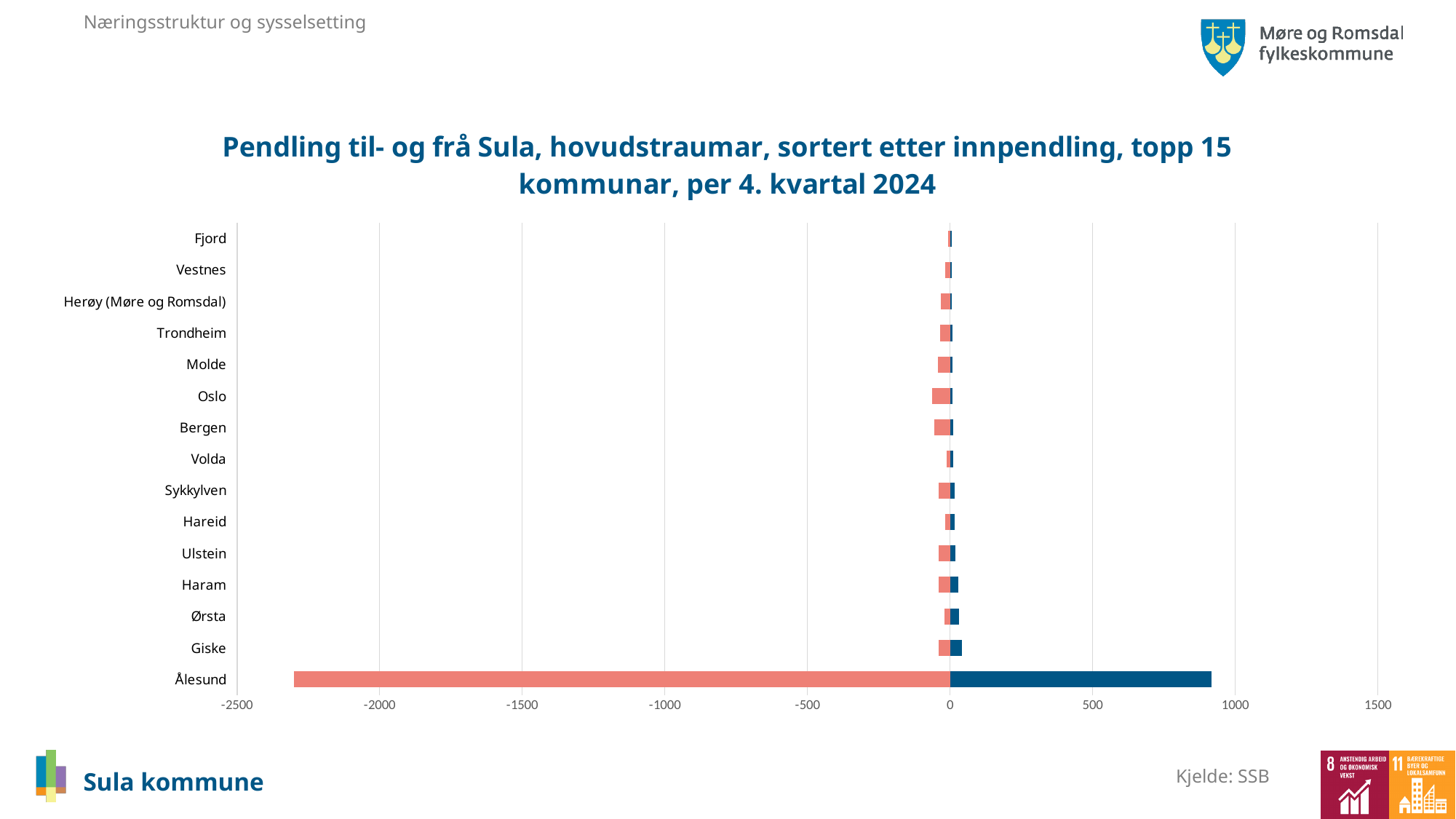
Which has the longer red (negative) bar, Ålesund or Oslo? Ålesund Is the blue (positive) value for Ålesund greater or less than 1000? less What kind of chart is shown on the slide? bar chart Which has the larger blue (positive) bar, Ålesund or Giske? Ålesund Is the blue (positive) value for Giske greater or less than 500? less Which municipality is listed at the top of the vertical axis? Fjord What is the lowest value shown on the horizontal axis of the chart? -2500 Is the blue (positive) value for Ålesund greater or less than 500? greater Which municipality has the longest blue (positive) bar in the chart? Ålesund How many municipalities (categories) are listed on the vertical axis of the chart? 15 Which municipality has the longest red (negative) bar in the chart? Ålesund